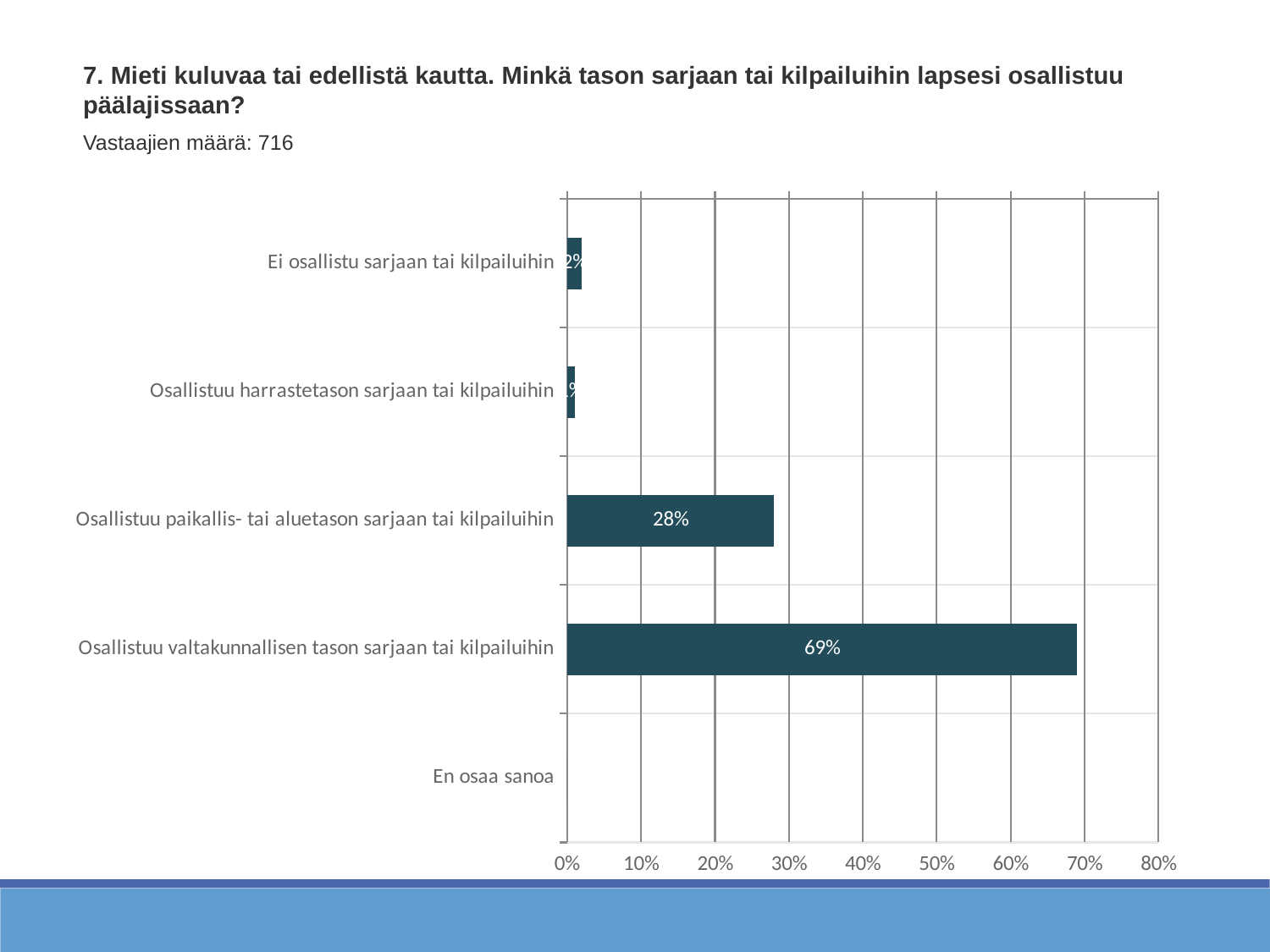
What kind of chart is shown on the slide? Bar chart Which category has the lowest value? En osaa sanoa How many respondents (Vastaajien määrä) are reported on the slide? 716 What is the value for "Osallistuu valtakunnallisen tason sarjaan tai kilpailuihin"? 69% What is the value for "Osallistuu paikallis- tai aluetason sarjaan tai kilpailuihin"? 28% Is the value for "Ei osallistu sarjaan tai kilpailuihin" greater or less than 10%? less Is the value for "Osallistuu harrastetason sarjaan tai kilpailuihin" greater or less than 10%? less Which category has the highest value? Osallistuu valtakunnallisen tason sarjaan tai kilpailuihin How many categories are shown in the chart? 5 Which is larger: the value for "Osallistuu paikallis- tai aluetason sarjaan tai kilpailuihin" or for "Osallistuu valtakunnallisen tason sarjaan tai kilpailuihin"? Osallistuu valtakunnallisen tason sarjaan tai kilpailuihin Is the value for "Osallistuu valtakunnallisen tason sarjaan tai kilpailuihin" greater or less than 60%? greater What is the difference between the values for "Osallistuu valtakunnallisen tason sarjaan tai kilpailuihin" and "Osallistuu paikallis- tai aluetason sarjaan tai kilpailuihin"? 41 percentage points